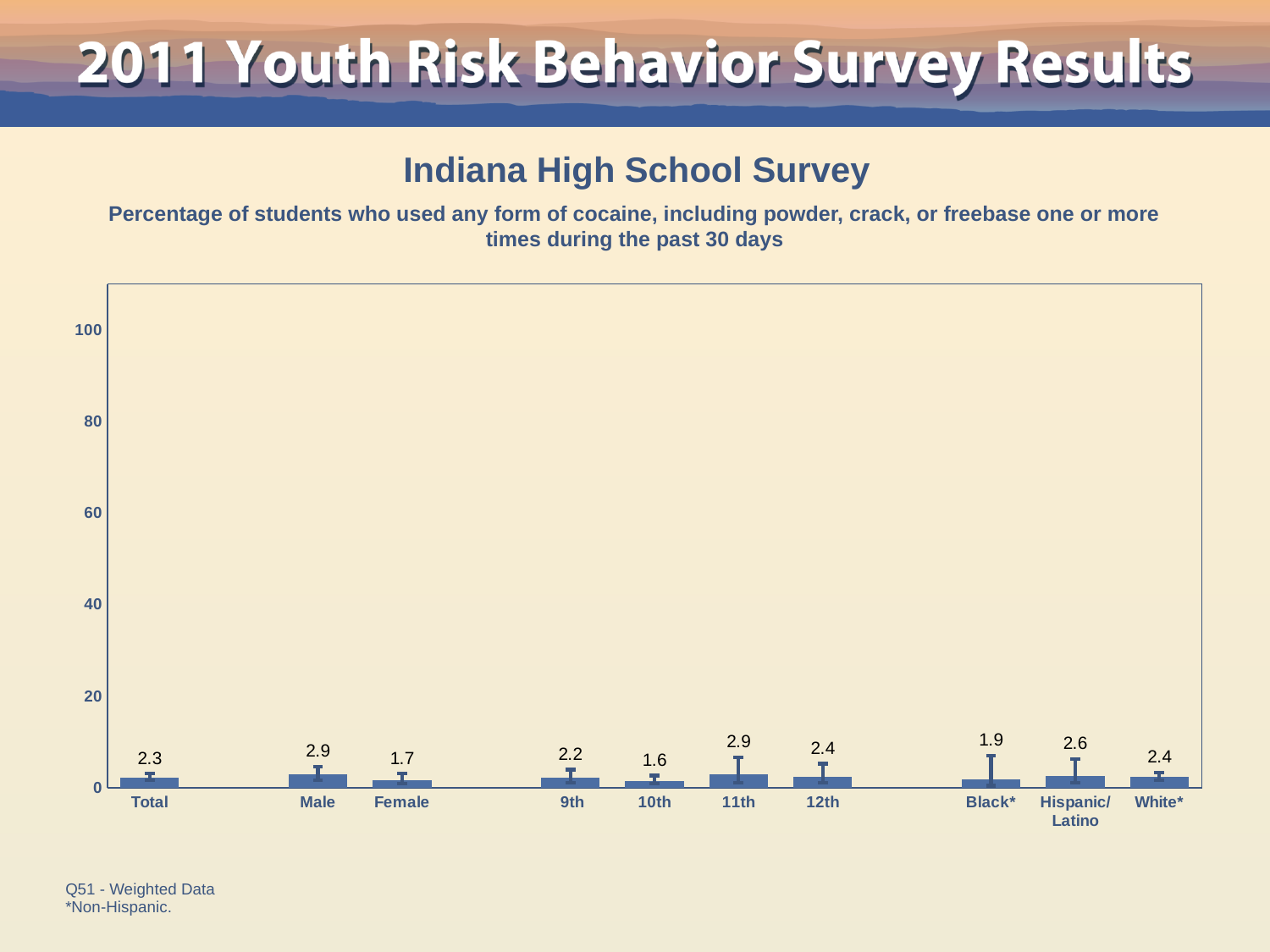
How many categories are shown on the x axis? 10 Is the value for Black* greater or less than 20? less What is the value for Hispanic/Latino? 2.6 What is the title of the chart? Indiana High School Survey What is the value for Male? 2.9 What kind of chart is shown? bar chart What is the value for Total? 2.3 Which is larger, the value for 9th grade or the value for 11th grade? 11th What is the value for 10th grade? 1.6 What is the difference between the Male and Female values? 1.2 What is the value for Female? 1.7 Which category has the lowest value? 10th